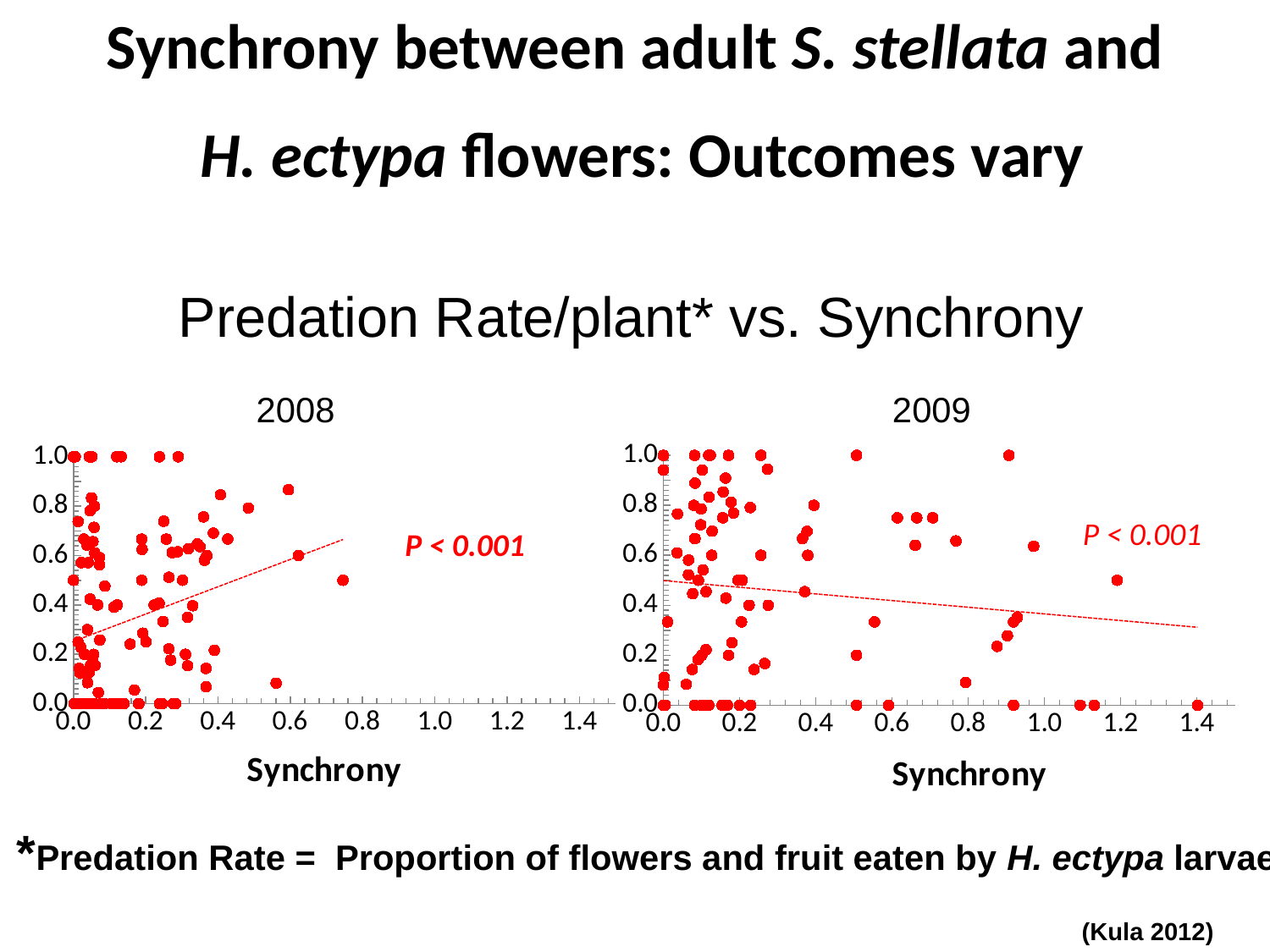
What kind of chart is the 2009 chart? scatter chart In the 2009 chart, does the fitted trend line rise or fall as Synchrony increases? falls What P value is shown next to the 2009 chart? P < 0.001 In the 2008 chart, is the trend line's value at Synchrony 0.0 greater or less than 0.4? less In the 2009 chart, is the trend line's value at Synchrony 1.4 greater or less than 0.4? less What is the highest tick value on the y axis of the 2008 chart? 1.0 What kind of chart is the 2008 chart? scatter chart Which year's chart shows a negative relationship between predation rate and synchrony? 2009 What is the x-axis label of the 2008 chart? Synchrony What is the highest tick value on the x axis of the 2009 chart? 1.4 How many scatter charts are shown on the slide? 2 In the 2008 chart, does the fitted trend line rise or fall as Synchrony increases? rises